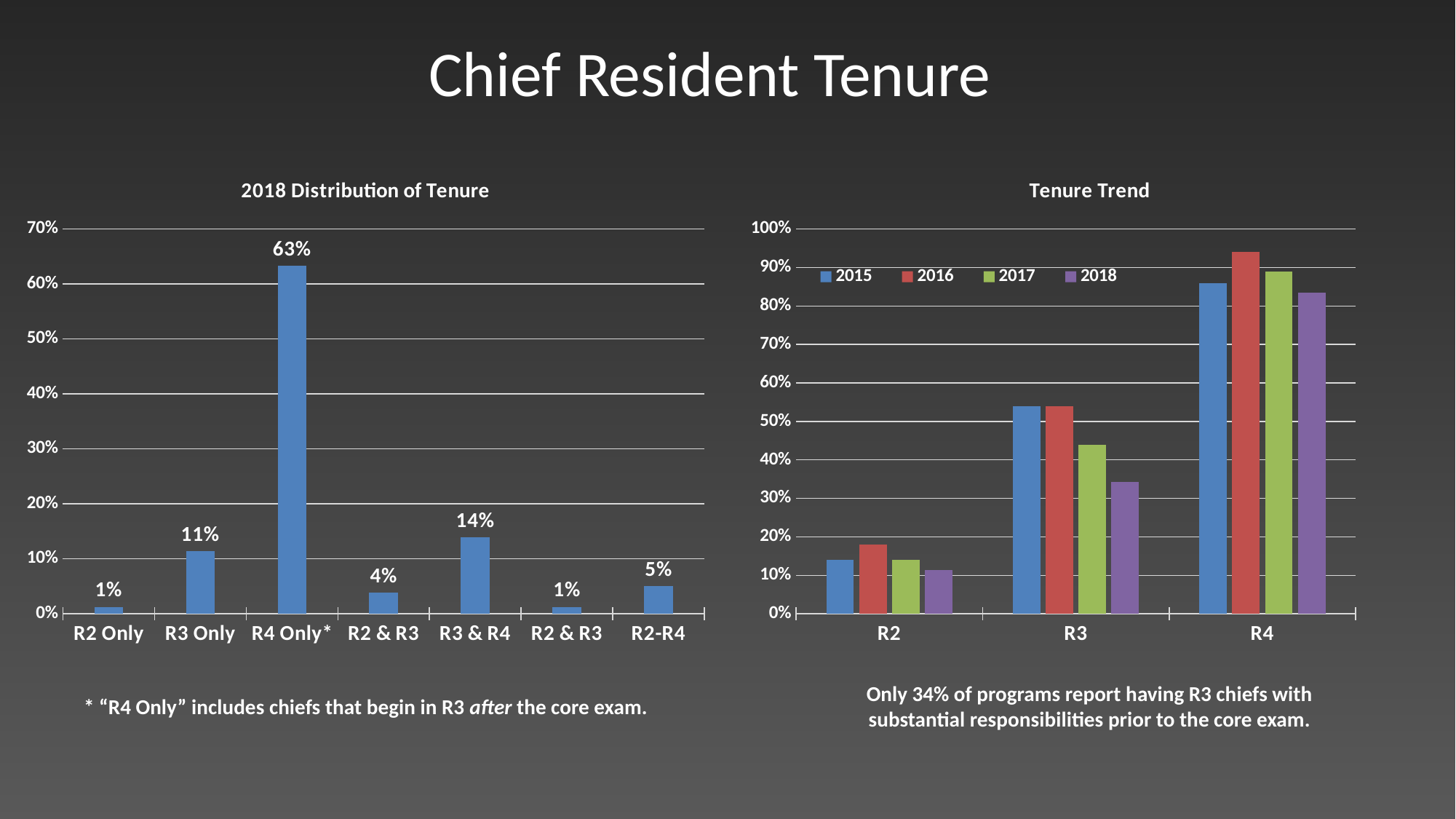
In the Tenure Trend chart, is the value for R4 in 2016 greater or less than 90%? greater In the 2018 Distribution of Tenure chart, what is the value for R2-R4? 5% In the 2018 Distribution of Tenure chart, what is the value for R3 & R4? 14% In the Tenure Trend chart, how many series does the legend list? 4 In the Tenure Trend chart, is the value for R3 in 2018 greater or less than 40%? less In the 2018 Distribution of Tenure chart, what is the value for R4 Only*? 63% In the 2018 Distribution of Tenure chart, which is larger, R3 Only or R2-R4? R3 Only In the 2018 Distribution of Tenure chart, what is the difference between R3 & R4 and R3 Only? 3% In the 2018 Distribution of Tenure chart, which category has the highest value? R4 Only* What kind of chart is the Tenure Trend chart? bar chart In the 2018 Distribution of Tenure chart, how many categories are shown on the x axis? 7 In the Tenure Trend chart, do the R3 values rise or fall from 2015 to 2018? fall